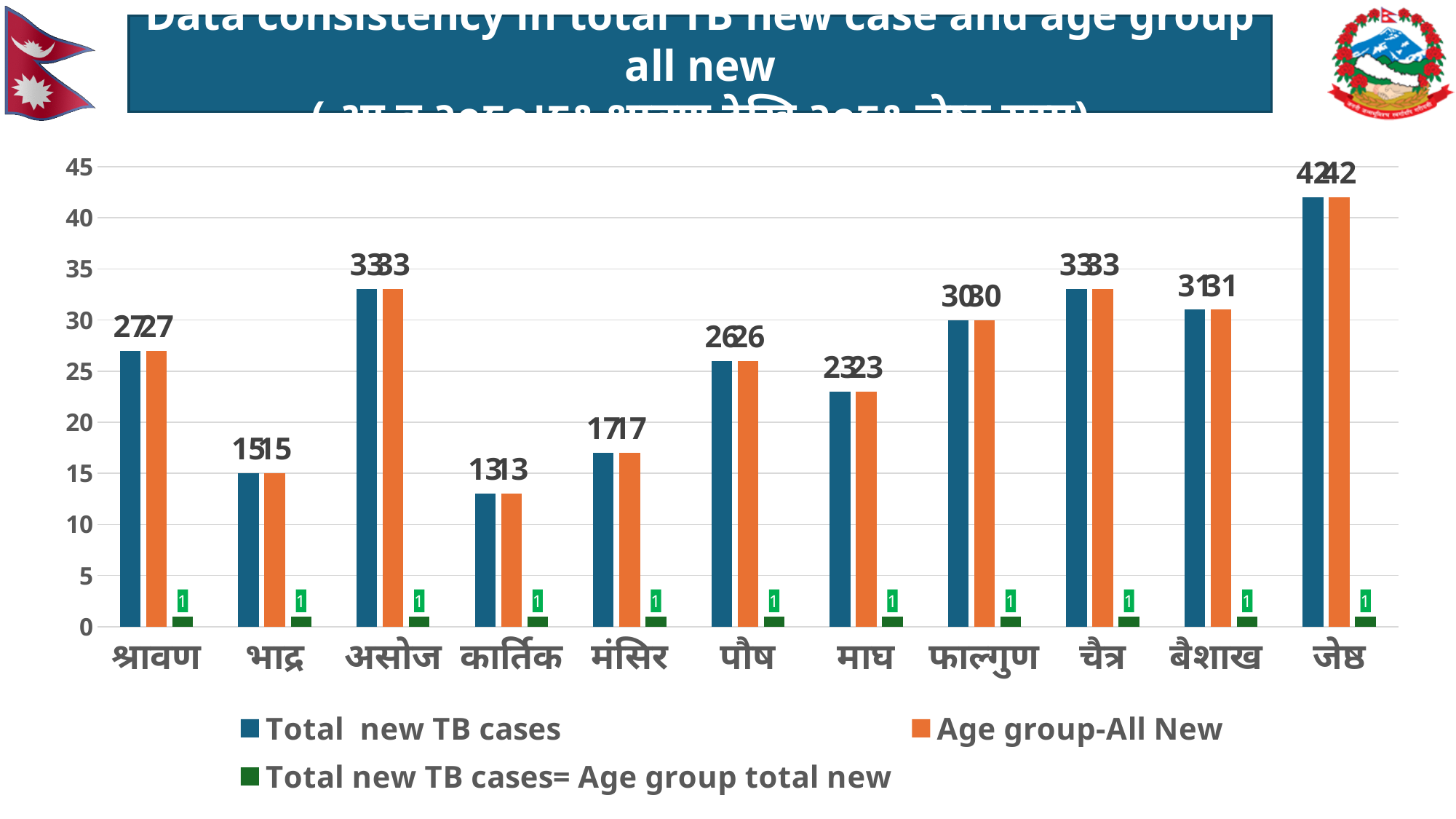
Which is larger, the Total new TB cases for पौष or for माघ? पौष How many series does the legend list? 3 What is the value of Age group-All New for जेष्ठ? 42 What is the value of Total new TB cases for कार्तिक? 13 What is the difference between the Total new TB cases for जेष्ठ and for भाद्र? 27 What is the value of the green series (Total new TB cases= Age group total new) for फाल्गुण? 1 What is the value of Total new TB cases for श्रावण? 27 Which month has the highest value for Total new TB cases? जेष्ठ Which month has the lowest value for Age group-All New? कार्तिक How many months are shown on the x axis? 11 What kind of chart is shown on the slide? Bar chart Which colour represents the Age group-All New series? Orange